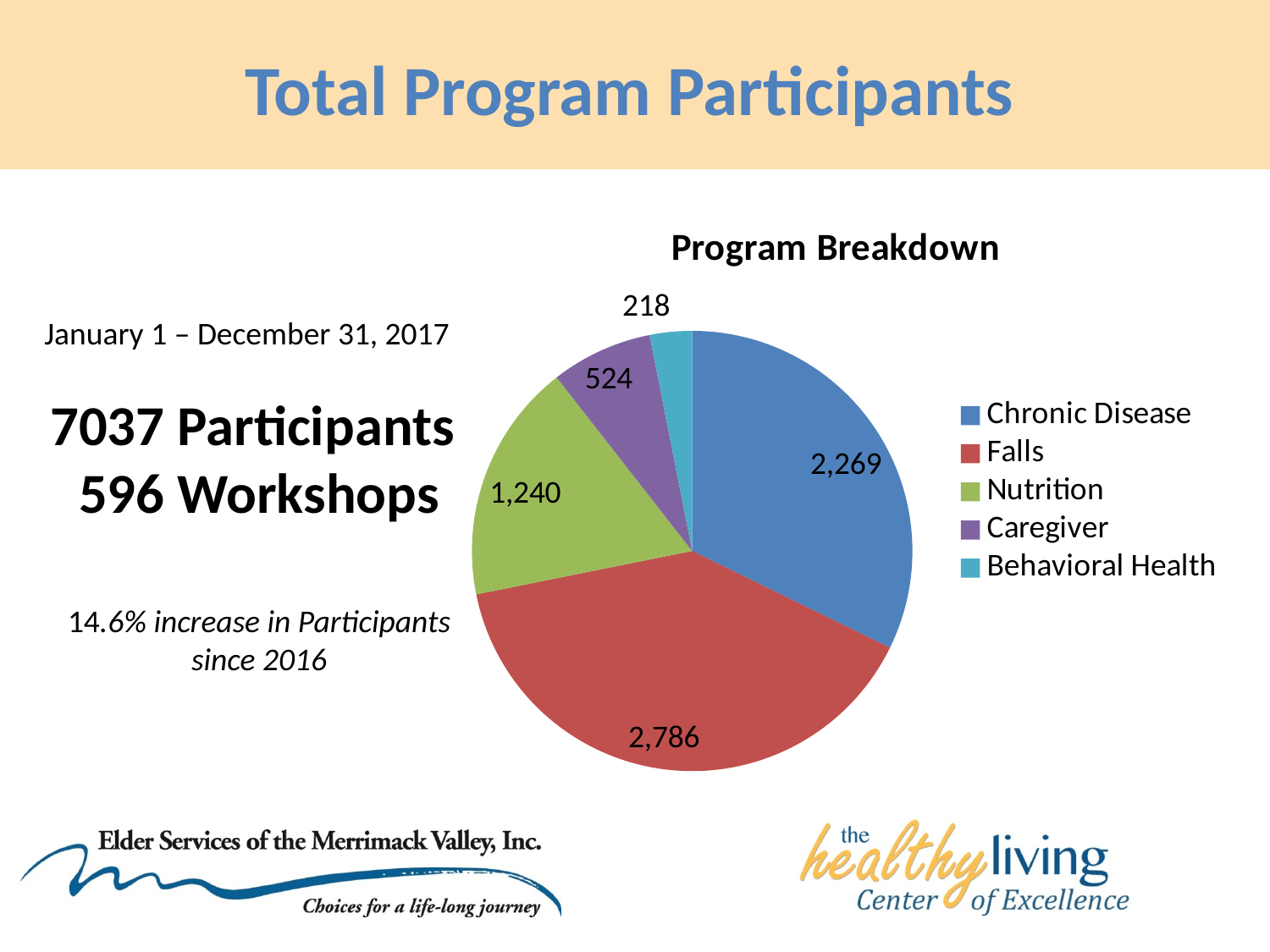
What is the value for Nutrition in the Program Breakdown pie chart? 1,240 What type of chart is used for the Program Breakdown? Pie chart What is the difference between the Falls and Chronic Disease values in the Program Breakdown pie chart? 517 What is the difference between the Nutrition and Caregiver values in the Program Breakdown pie chart? 716 Which is larger in the Program Breakdown pie chart, Nutrition or Caregiver? Nutrition Which program has the largest slice in the Program Breakdown pie chart? Falls How many programs are shown in the Program Breakdown pie chart? 5 What is the value for Falls in the Program Breakdown pie chart? 2,786 What is the value for Caregiver in the Program Breakdown pie chart? 524 What is the value for Chronic Disease in the Program Breakdown pie chart? 2,269 Which program has the smallest slice in the Program Breakdown pie chart? Behavioral Health What is the value for Behavioral Health in the Program Breakdown pie chart? 218